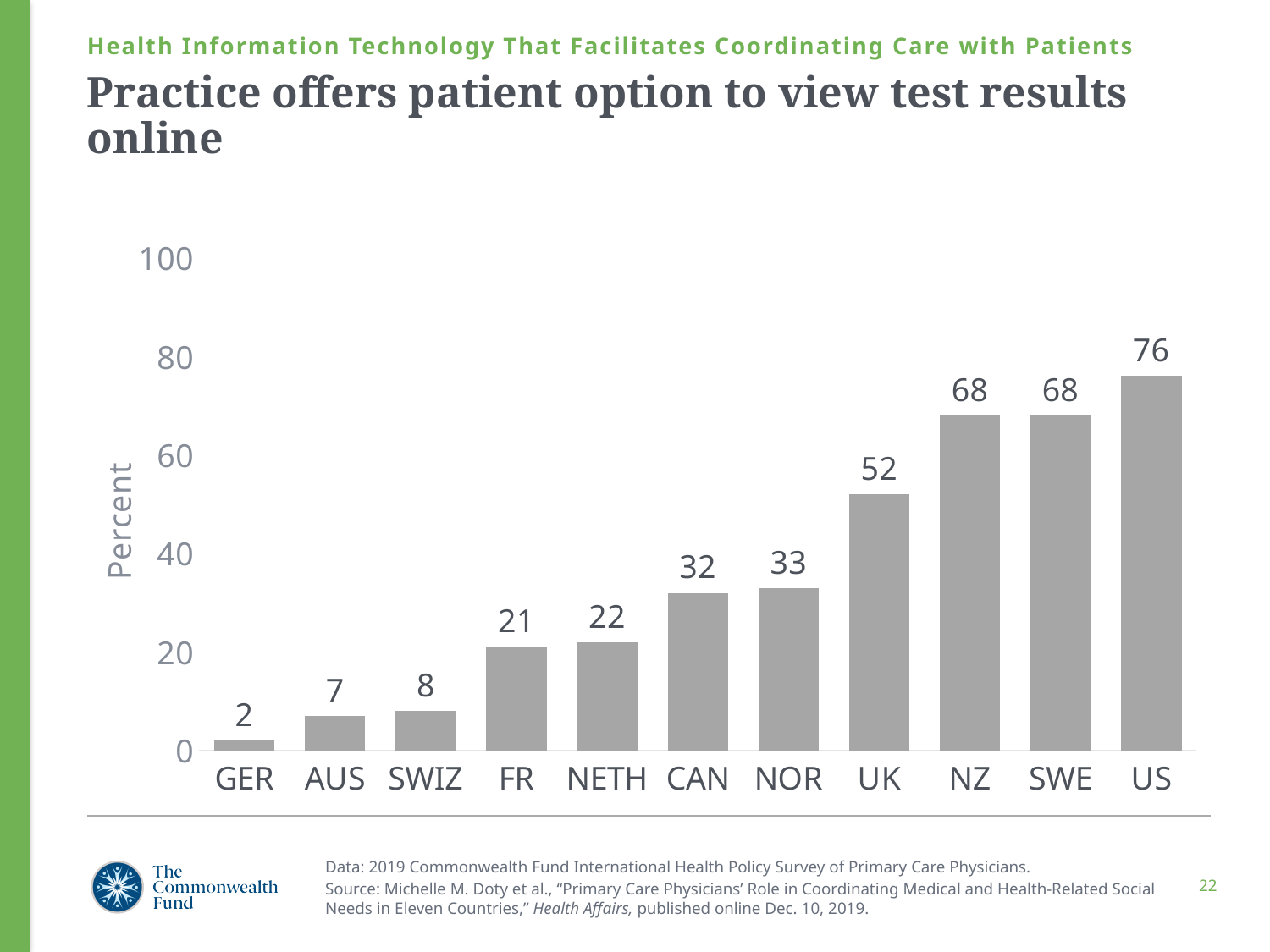
Which country has the lowest value? GER What is the value for GER? 2 What is the value for the UK? 52 Which is larger, the value for CAN or the value for NOR? NOR What is the difference between the values for the US and the UK? 24 Do the values generally rise or fall from left to right along the x axis? rise What kind of chart is shown on the slide? bar chart Is the value for NZ greater or less than 60? greater How many countries are shown on the chart? 11 What is the value for the US? 76 Which country has the highest value? US What is the label on the vertical axis? Percent